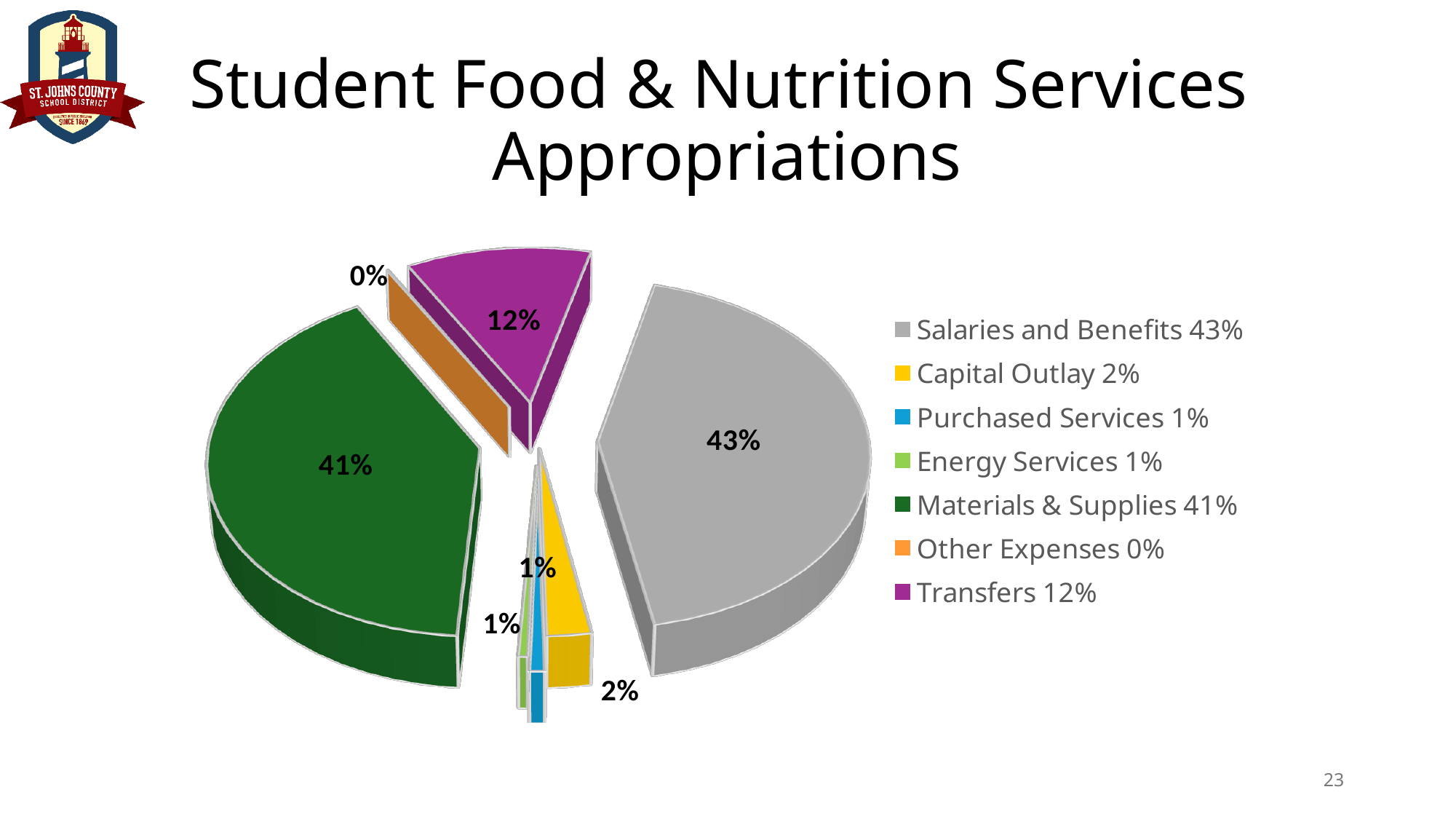
What is the value shown for Other Expenses? 0% Which category has the smallest share of the pie? Other Expenses Which category has the largest share of the pie? Salaries and Benefits What is the value shown for Capital Outlay? 2% What is the difference in percentage points between Salaries and Benefits and Materials & Supplies? 2% What share of the pie does Transfers represent? 12% What colour is the Materials & Supplies slice? Green What share of the pie does Salaries and Benefits represent? 43% What kind of chart is shown on the slide? Pie chart What share of the pie does Materials & Supplies represent? 41% How many categories does the legend list? 7 Which is larger, Transfers or Capital Outlay? Transfers